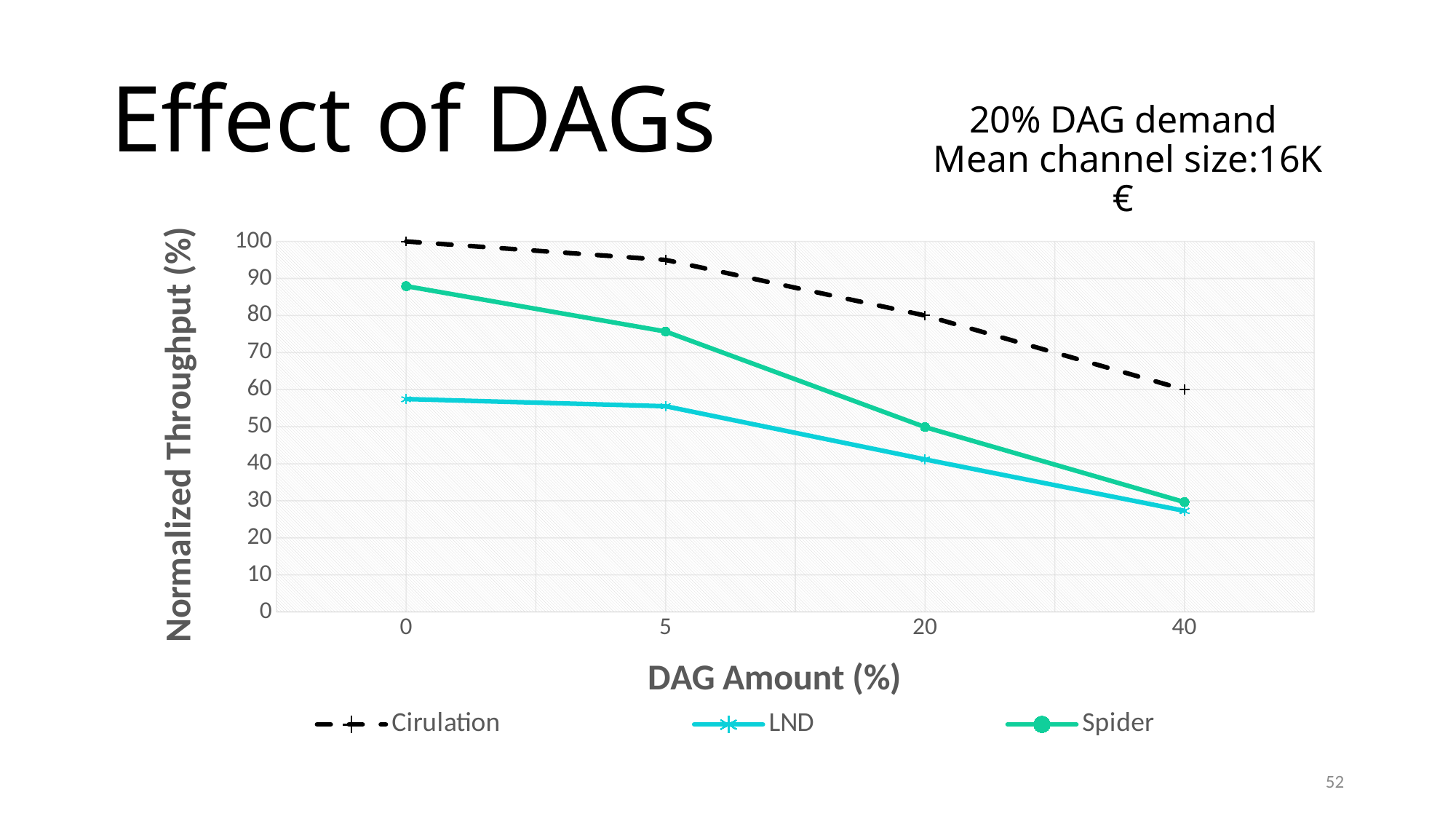
How many DAG Amount values are plotted along the x axis? 4 Does the Normalized Throughput for Spider rise or fall as the DAG Amount increases? fall What is the Normalized Throughput for Cirulation at a DAG Amount of 40%? 60 What is the Normalized Throughput for Cirulation at a DAG Amount of 0%? 100 How many series does the legend list? 3 Which series has the lowest Normalized Throughput at a DAG Amount of 0%? LND At a DAG Amount of 20%, which series has the higher Normalized Throughput, Cirulation or Spider? Cirulation Is the Normalized Throughput for LND at a DAG Amount of 40% greater or less than 30? less Is the Normalized Throughput for Spider at a DAG Amount of 0% greater or less than 80? greater What is the difference in Normalized Throughput for Cirulation between a DAG Amount of 0% and 40%? 40 What type of chart is shown on the slide? line chart